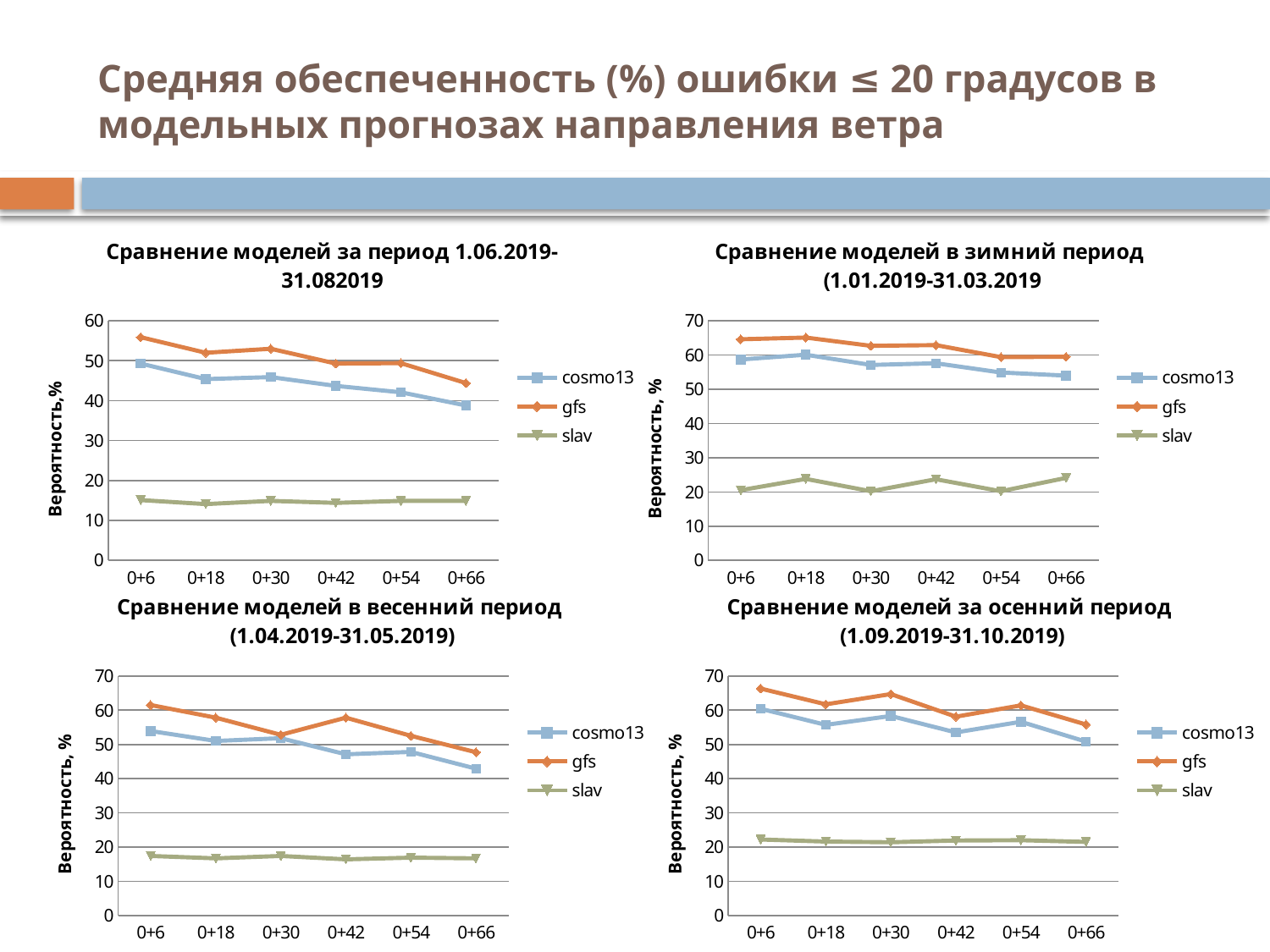
In the top-left chart 'Сравнение моделей за период 1.06.2019-31.082019', is the value for cosmo13 at 0+66 greater or less than 40? less In the bottom-right chart 'Сравнение моделей за осенний период', which is larger at 0+6: gfs or cosmo13? gfs In the bottom-right chart 'Сравнение моделей за осенний период', which series has the highest values? gfs In the bottom-left chart 'Сравнение моделей в весенний период', is the value for slav at 0+6 greater or less than 20? less In the top-right chart 'Сравнение моделей в зимний период', is the value for gfs at 0+18 greater or less than 60? greater What is the y-axis label of the top-right chart 'Сравнение моделей в зимний период'? Вероятность, % In the bottom-left chart 'Сравнение моделей в весенний период', does the cosmo13 series rise or fall from 0+6 to 0+66? fall What kind of chart is the top-left chart titled 'Сравнение моделей за период 1.06.2019-31.082019'? line chart How many points are plotted along the x axis in the bottom-left chart 'Сравнение моделей в весенний период'? 6 In the top-left chart 'Сравнение моделей за период 1.06.2019-31.082019', which series has the lowest values? slav How many series does the legend list in the top-right chart 'Сравнение моделей в зимний период'? 3